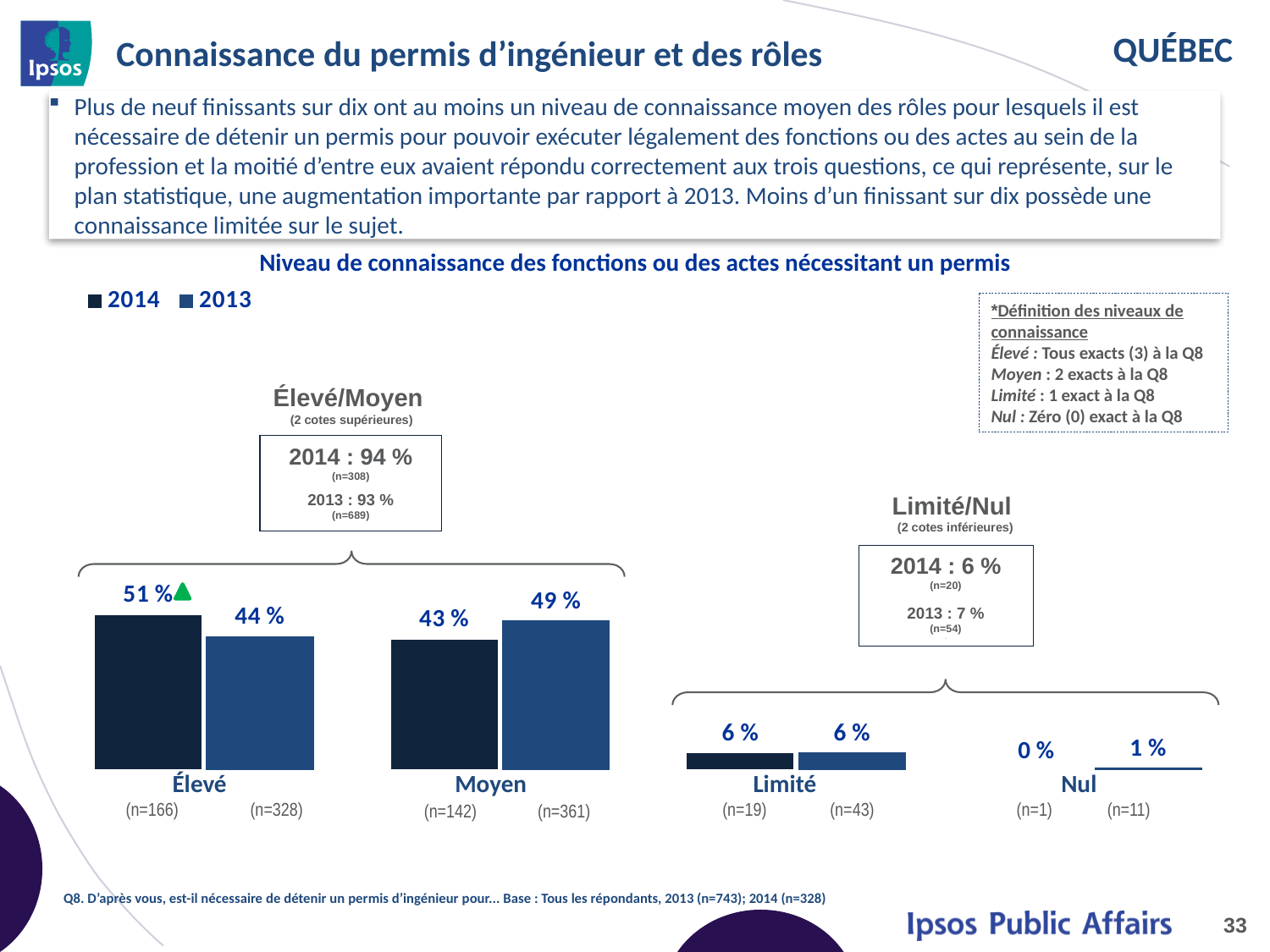
What kind of chart is shown? bar chart What is the 2013 value for Moyen? 49 % What is the 2014 value for Limité? 6 % What is the difference between the 2014 and 2013 values for Élevé? 7 % Which category has the lowest 2013 value? Nul Which category has the highest 2014 value? Élevé What is the title of the chart? Niveau de connaissance des fonctions ou des actes nécessitant un permis For Moyen, which is larger: the 2014 value or the 2013 value? 2013 What is the 2014 value for Élevé? 51 % What is the 2013 value for Nul? 1 % How many series does the legend list? 2 How many categories are shown on the x axis? 4